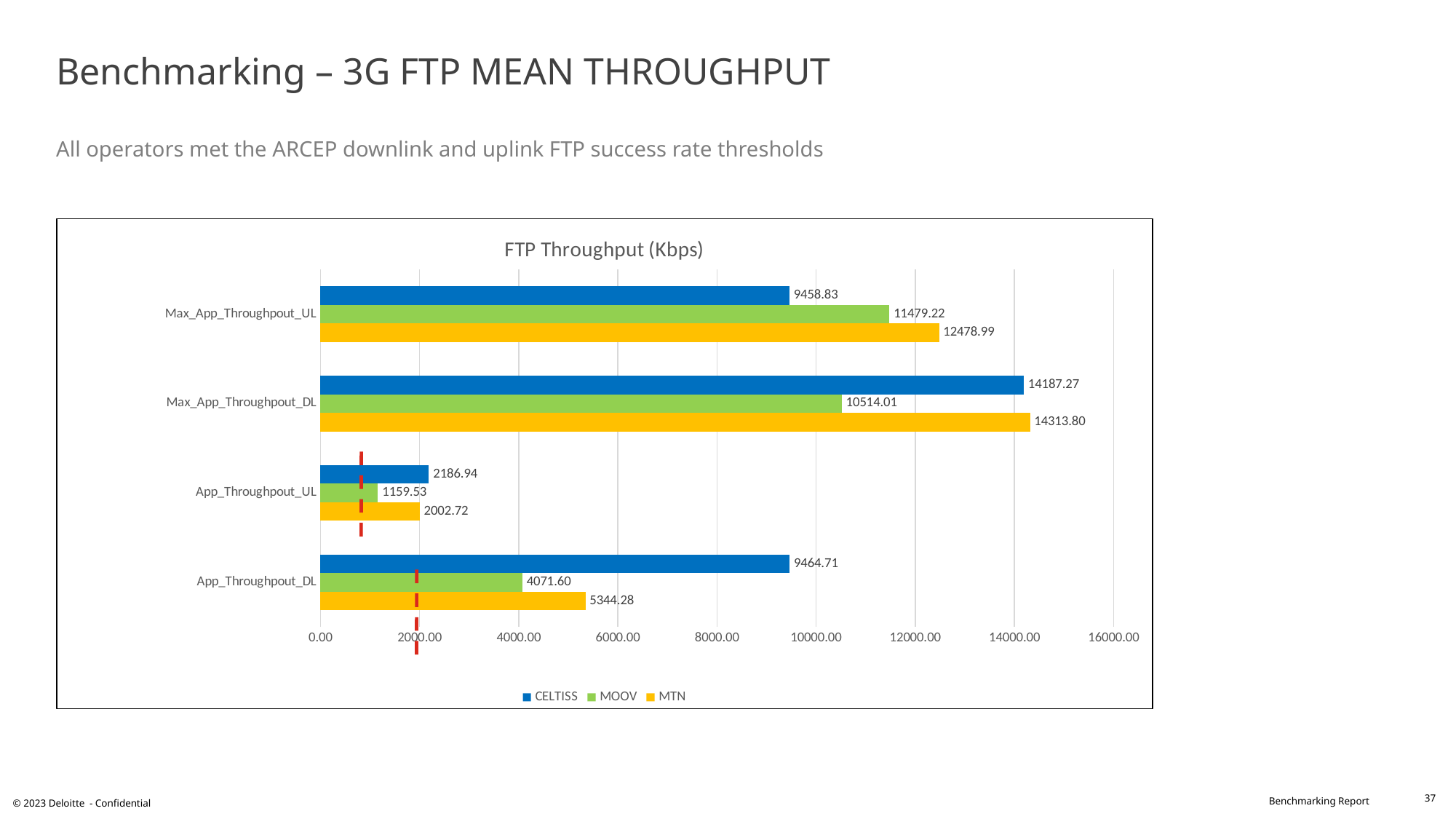
What is the MTN value for Max_App_Throughpout_DL? 14313.80 What is the CELTISS value for App_Throughpout_DL? 9464.71 What is the MOOV value for App_Throughpout_UL? 1159.53 What type of chart is shown on the slide? bar chart Which colour represents MOOV in the chart? green Which operator has the lowest value for App_Throughpout_DL? MOOV Which operator has the highest value for Max_App_Throughpout_UL? MTN For App_Throughpout_UL, which is larger: the CELTISS value or the MTN value? CELTISS What is the title of the chart? FTP Throughput (Kbps) What is the difference between the CELTISS and MOOV values for App_Throughpout_DL? 5393.11 How many categories are shown on the chart? 4 How many series does the legend list? 3